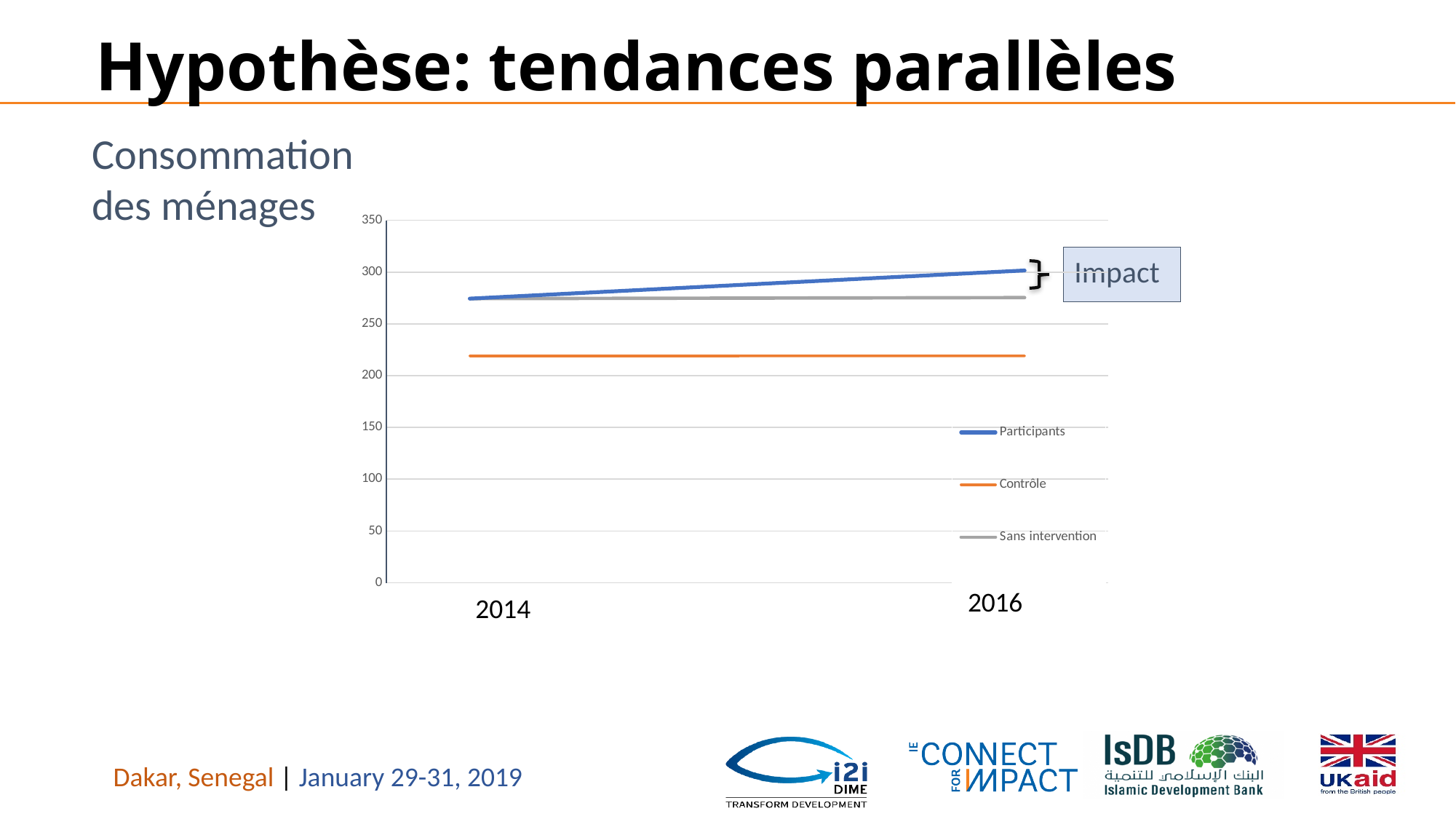
What kind of chart is shown on the slide? line chart Is the value for Contrôle in 2014 greater or less than 200? greater What word is written in the box next to the bracket at the right end of the lines? Impact Does the Contrôle line rise, fall or stay flat from 2014 to 2016? stay flat Which series has the lowest value in 2016? Contrôle Which series has the highest value in 2016? Participants Does the Participants line rise or fall from 2014 to 2016? rise Is the value for Participants in 2016 greater or less than 250? greater In 2016, which is larger: Participants or Sans intervention? Participants How many years are labelled on the x axis? 2 Is the value for Contrôle in 2016 greater or less than 250? less How many series does the legend list? 3